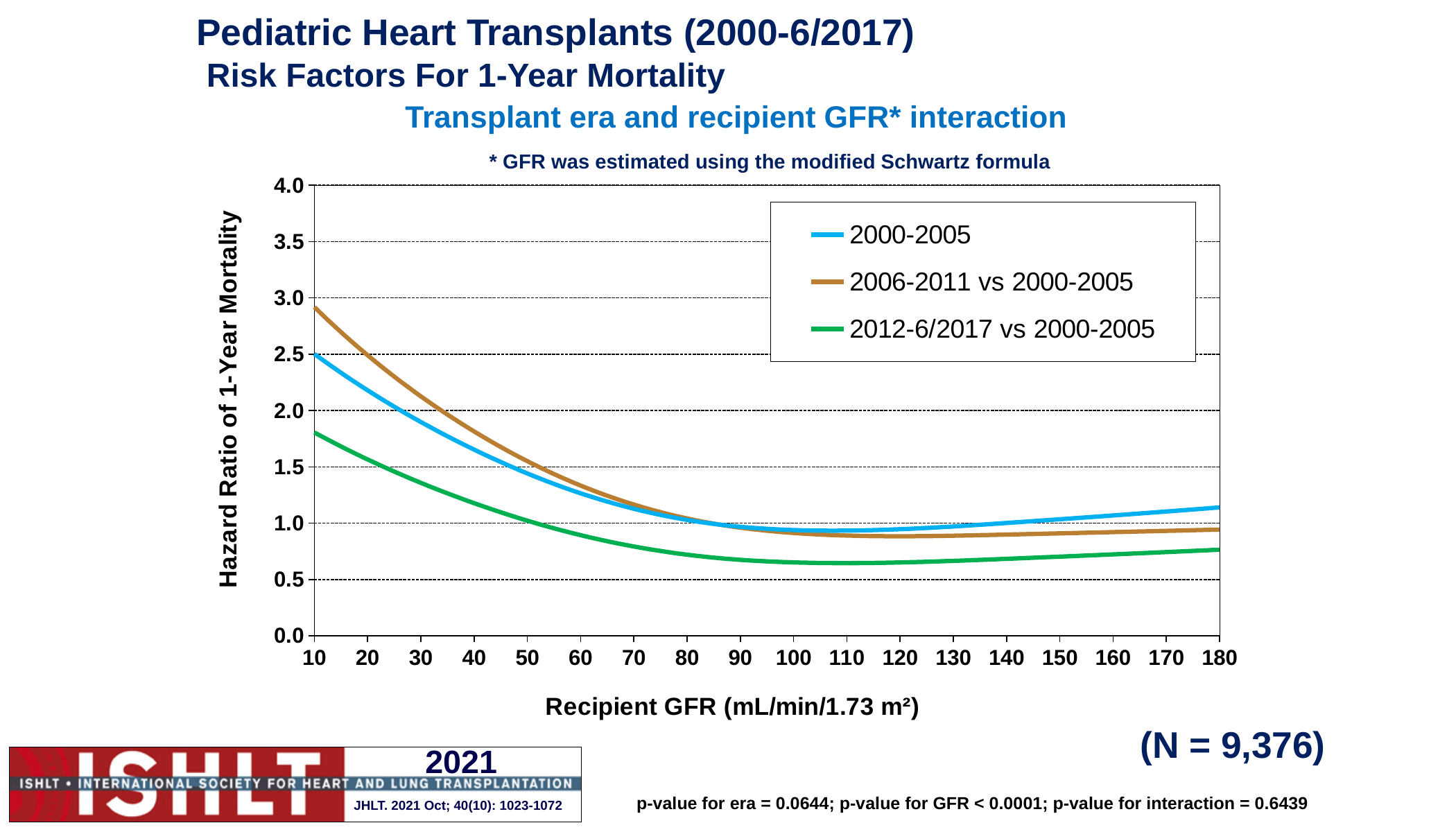
At a GFR of 10, which line has the higher hazard ratio: 2006-2011 vs 2000-2005 or 2012-6/2017 vs 2000-2005? 2006-2011 vs 2000-2005 What kind of chart is shown on the slide? line chart Which series has the highest hazard ratio at a GFR of 180? 2000-2005 Is the hazard ratio for the 2006-2011 vs 2000-2005 line at a GFR of 10 greater or less than 2.5? greater Is the hazard ratio for the 2012-6/2017 vs 2000-2005 line at a GFR of 100 greater or less than 1.0? less Is the hazard ratio for the 2012-6/2017 vs 2000-2005 line at a GFR of 10 greater or less than 2.0? less How many series does the legend list? 3 What is the label of the y axis? Hazard Ratio of 1-Year Mortality Does the 2012-6/2017 vs 2000-2005 line rise or fall as GFR increases from 10 to 100? fall Which series has the lowest hazard ratio at a GFR of 10? 2012-6/2017 vs 2000-2005 What is the label of the x axis? Recipient GFR (mL/min/1.73 m²)